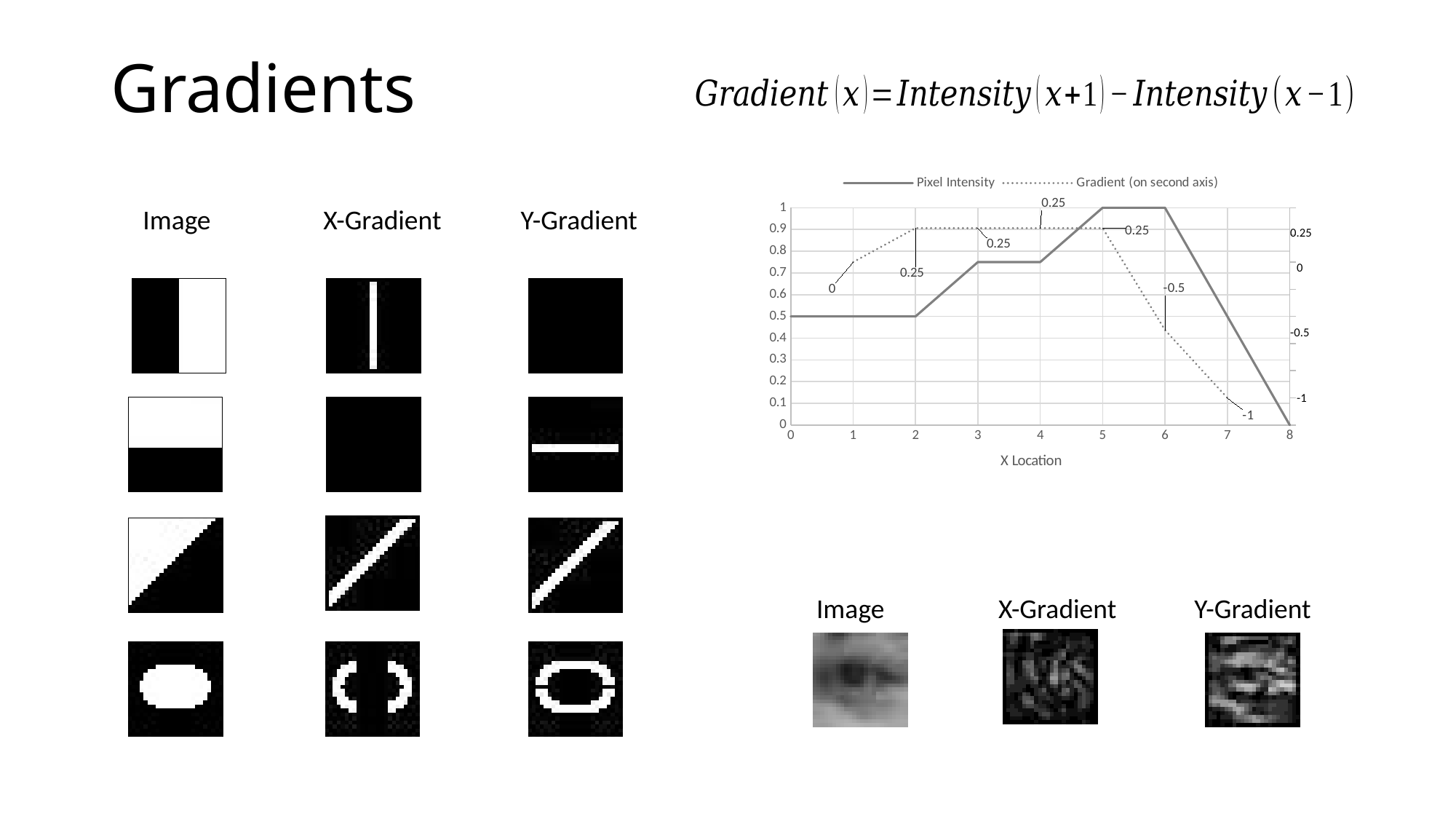
What is the Pixel Intensity at X Location 0? 0.5 What is the Pixel Intensity at X Location 8? 0 What is the Gradient value at X Location 6? -0.5 What is the Gradient value at X Location 7? -1 How many series does the chart's legend list? 2 What is the Gradient value at X Location 1? 0 What is the difference between the Gradient value at X Location 2 and at X Location 6? 0.75 Does the Pixel Intensity rise or fall from X Location 6 to X Location 8? fall At which X Location is the Gradient value lowest? 7 What kind of chart is shown on the slide? line chart Which is larger, the Pixel Intensity at X Location 5 or at X Location 2? X Location 5 Is the Pixel Intensity at X Location 3 greater or less than 0.7? greater